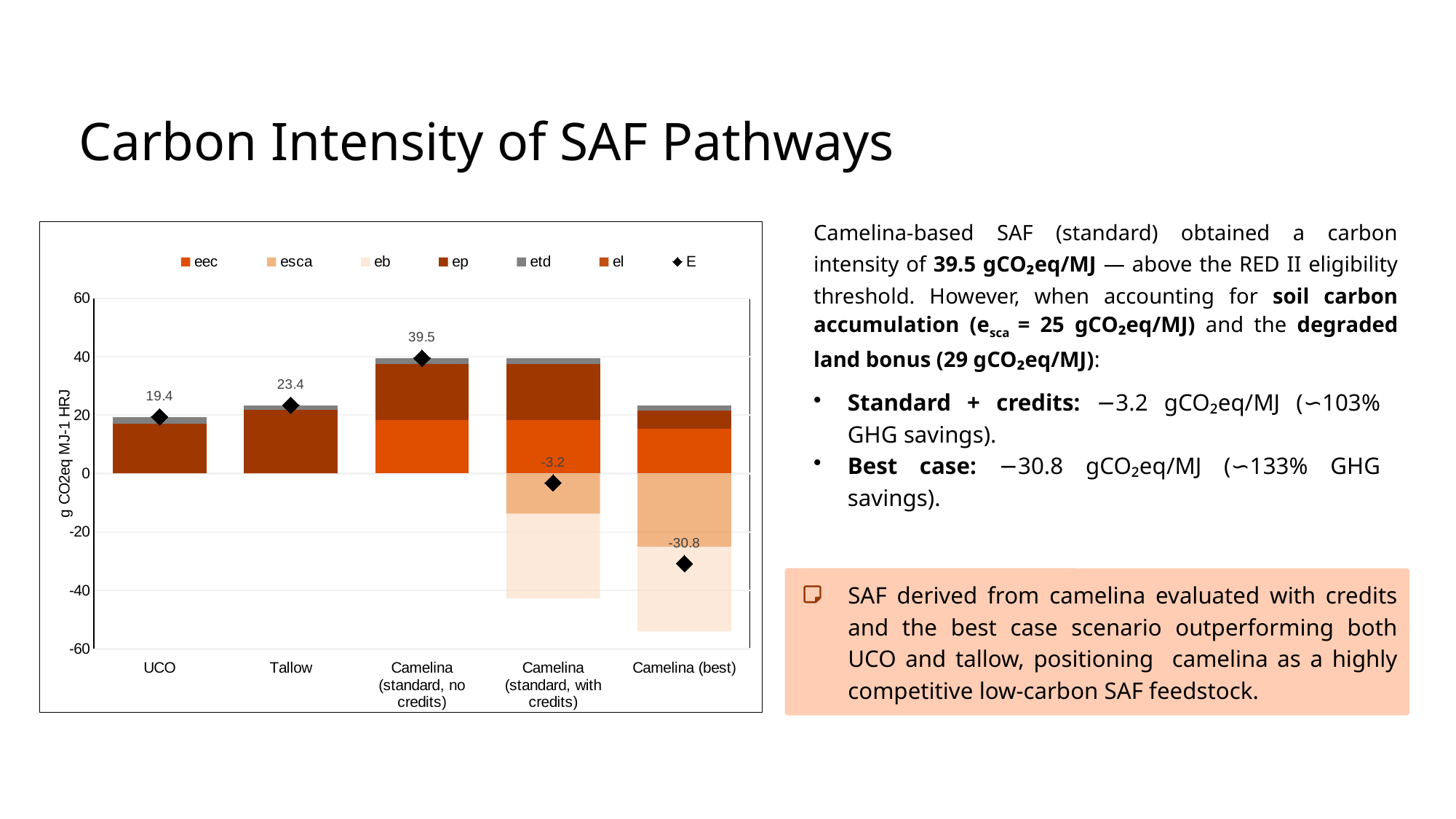
What is the E value shown for Tallow? 23.4 Which pathway has the highest E value? Camelina (standard, no credits) Which has a larger E value, UCO or Tallow? Tallow How many entries does the legend list? 7 What is the difference between the E values for Tallow and UCO? 4.0 Which pathway has the lowest E value? Camelina (best) What is the E value shown for Camelina (best)? -30.8 How many pathways are shown on the x axis? 5 What kind of chart is shown on the slide? bar chart What is the E value shown for Camelina (standard, no credits)? 39.5 What is the E value shown for UCO? 19.4 What is the E value shown for Camelina (standard, with credits)? -3.2